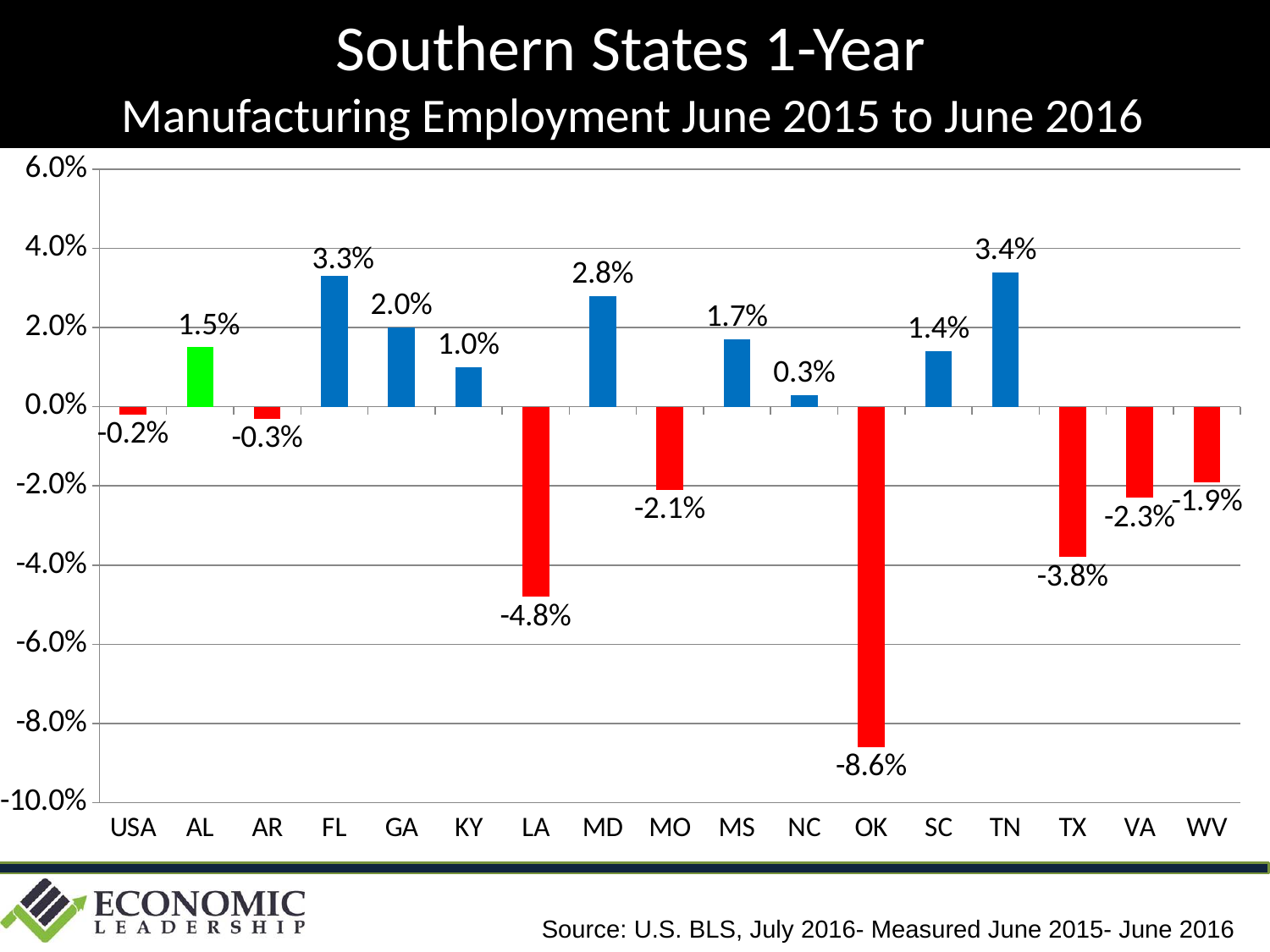
What is the difference between the values for TN and FL? 0.1% How many categories are shown on the x axis? 17 Which is larger, the value for GA or the value for SC? GA Which is lower, the value for LA or the value for TX? LA What colour is the bar for AL? green What is the value for USA? -0.2% What is the value for FL? 3.3% Which state has the lowest value? OK What is the difference between the values for MD and MS? 1.1% Which state has the highest value? TN What is the value for OK? -8.6% What kind of chart is this? bar chart